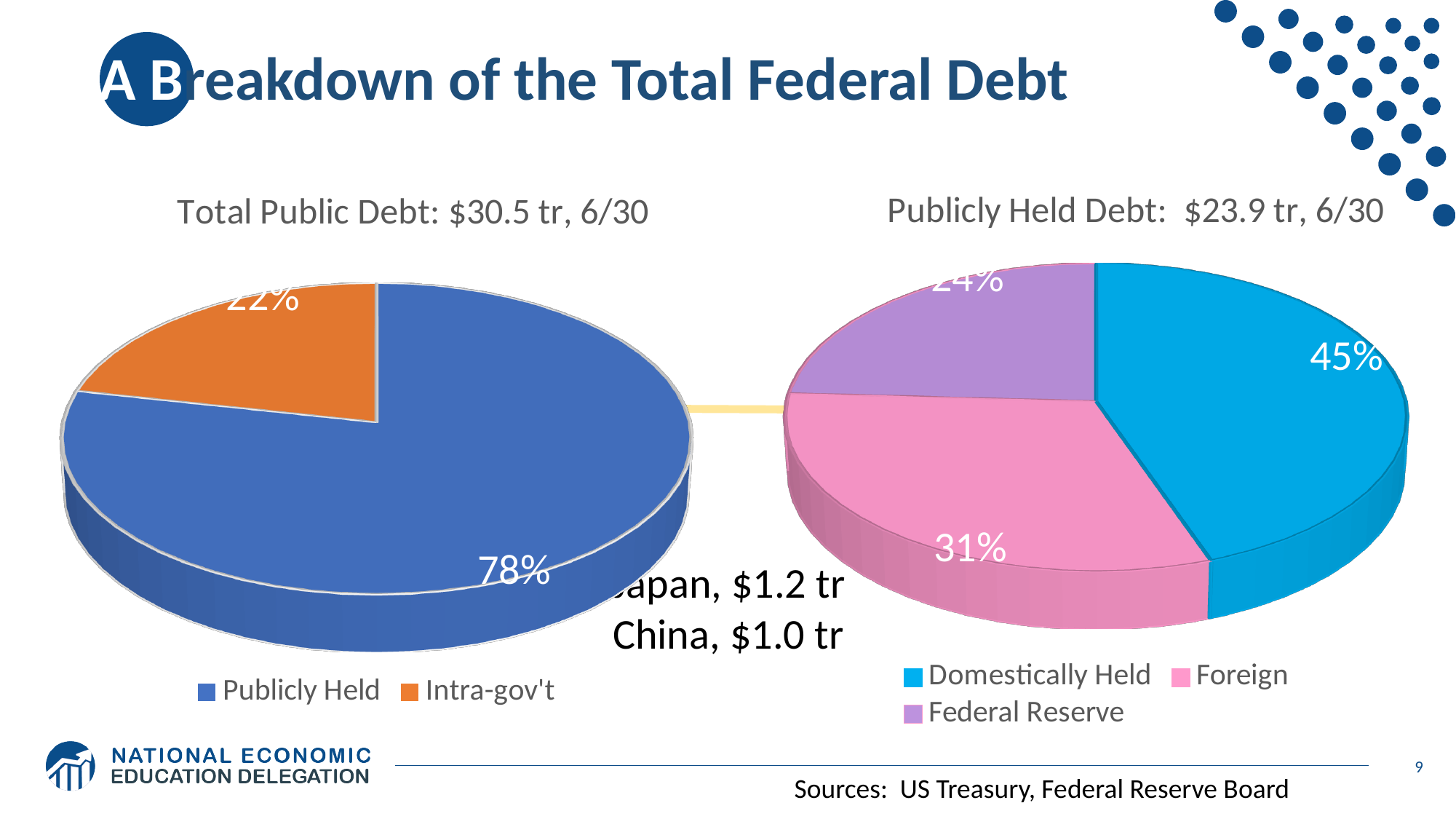
In the 'Total Public Debt' pie chart, what share is Publicly Held? 78% How many categories does the legend of the 'Publicly Held Debt' pie chart list? 3 In the 'Publicly Held Debt' pie chart, which category has the smallest share? Federal Reserve In the 'Publicly Held Debt' pie chart, which is larger, Foreign or Federal Reserve? Foreign What total amount is stated in the title of the 'Publicly Held Debt' chart? $23.9 tr In the 'Publicly Held Debt' pie chart, what share is Foreign? 31% In the 'Total Public Debt' pie chart, what is the difference in percentage points between Publicly Held and Intra-gov't? 56 In the 'Total Public Debt' pie chart, what share is Intra-gov't? 22% In the 'Publicly Held Debt' pie chart, what share is Domestically Held? 45% In the 'Publicly Held Debt' pie chart, which category has the largest share? Domestically Held What type of chart is used for the 'Total Public Debt' breakdown? Pie chart In the 'Publicly Held Debt' pie chart, what share is held by the Federal Reserve? 24%